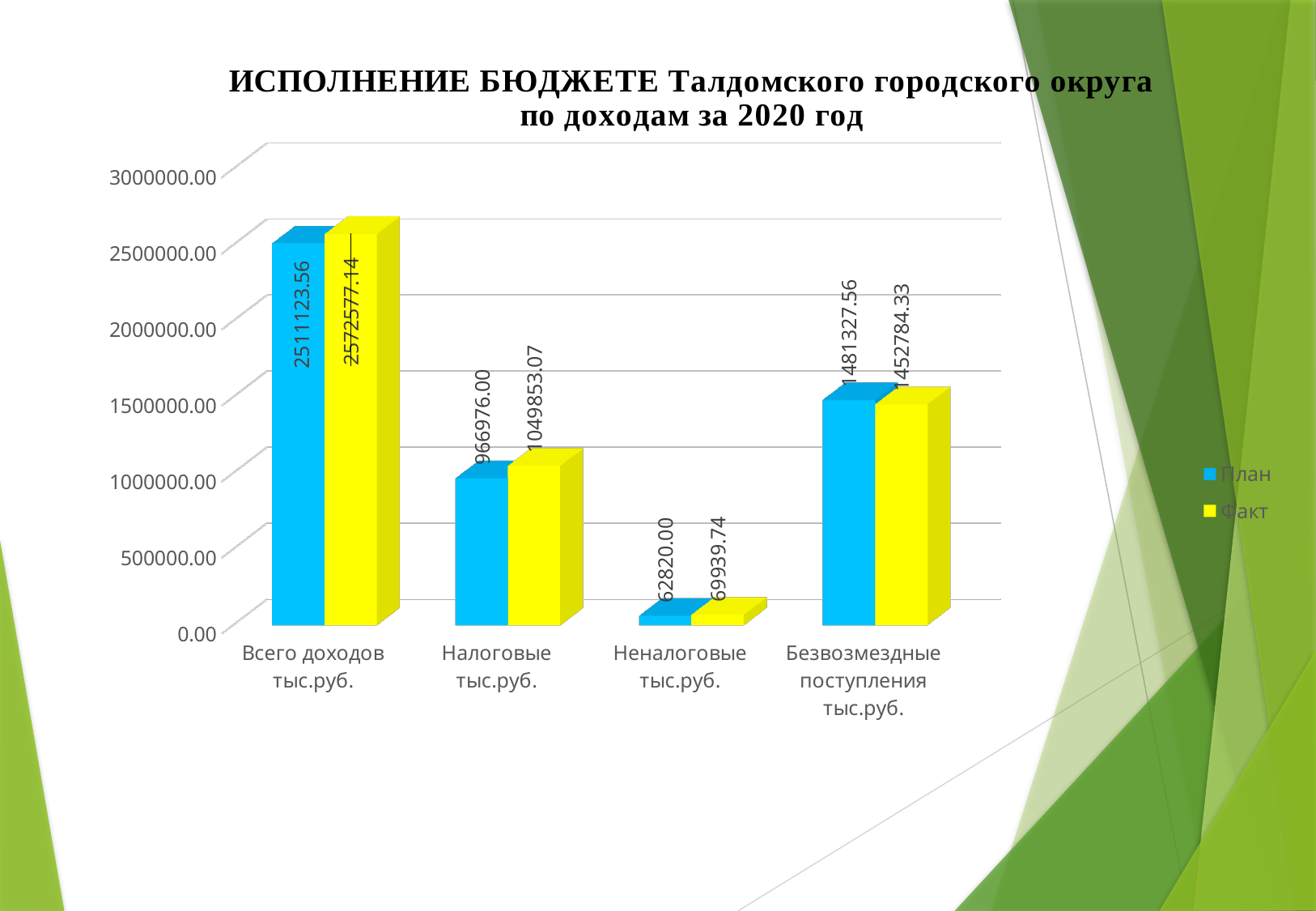
What is the difference between the Факт and План values for Налоговые тыс.руб.? 82877.07 What is the Факт value for Неналоговые тыс.руб.? 69939.74 Which category has the highest План value? Всего доходов тыс.руб. What kind of chart is shown on the slide? Bar chart What is the difference between the План and Факт values for Безвозмездные поступления тыс.руб.? 28543.23 Which category has the lowest Факт value? Неналоговые тыс.руб. What is the Факт value for Всего доходов тыс.руб.? 2572577.14 What is the План value for Безвозмездные поступления тыс.руб.? 1481327.56 For Безвозмездные поступления тыс.руб., which is larger, План or Факт? План How many series does the legend list? 2 How many categories are shown on the x axis? 4 What is the План value for Налоговые тыс.руб.? 966976.00